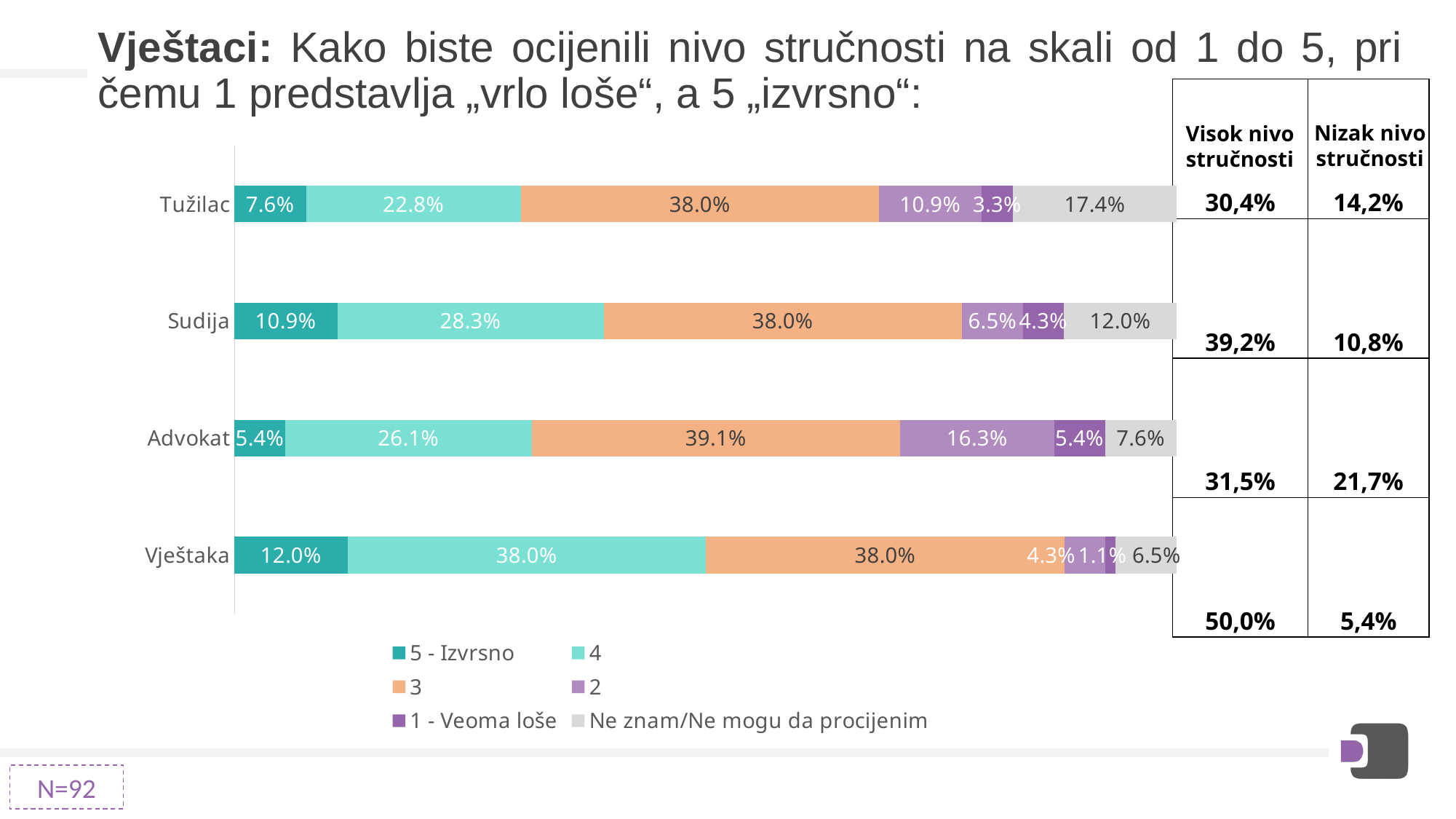
What is the total of all segments in the Tužilac bar? 100.0% How many series does the legend list? 6 What kind of chart is shown on the slide? Stacked bar chart How many categories are shown on the chart? 4 Which legend entry corresponds to the dark purple segments? 1 - Veoma loše What is the value of the "3" segment for Advokat? 39.1% What is the "Ne znam/Ne mogu da procijenim" value for Tužilac? 17.4% What percentage of respondents rated Sudija as "5 - Izvrsno"? 10.9% Which category has the highest "5 - Izvrsno" value? Vještaka Which category has the lowest "1 - Veoma loše" value? Vještaka How much larger is the "4" value for Vještaka than for Tužilac? 15.2 percentage points Which has a larger "2" value, Advokat or Sudija? Advokat